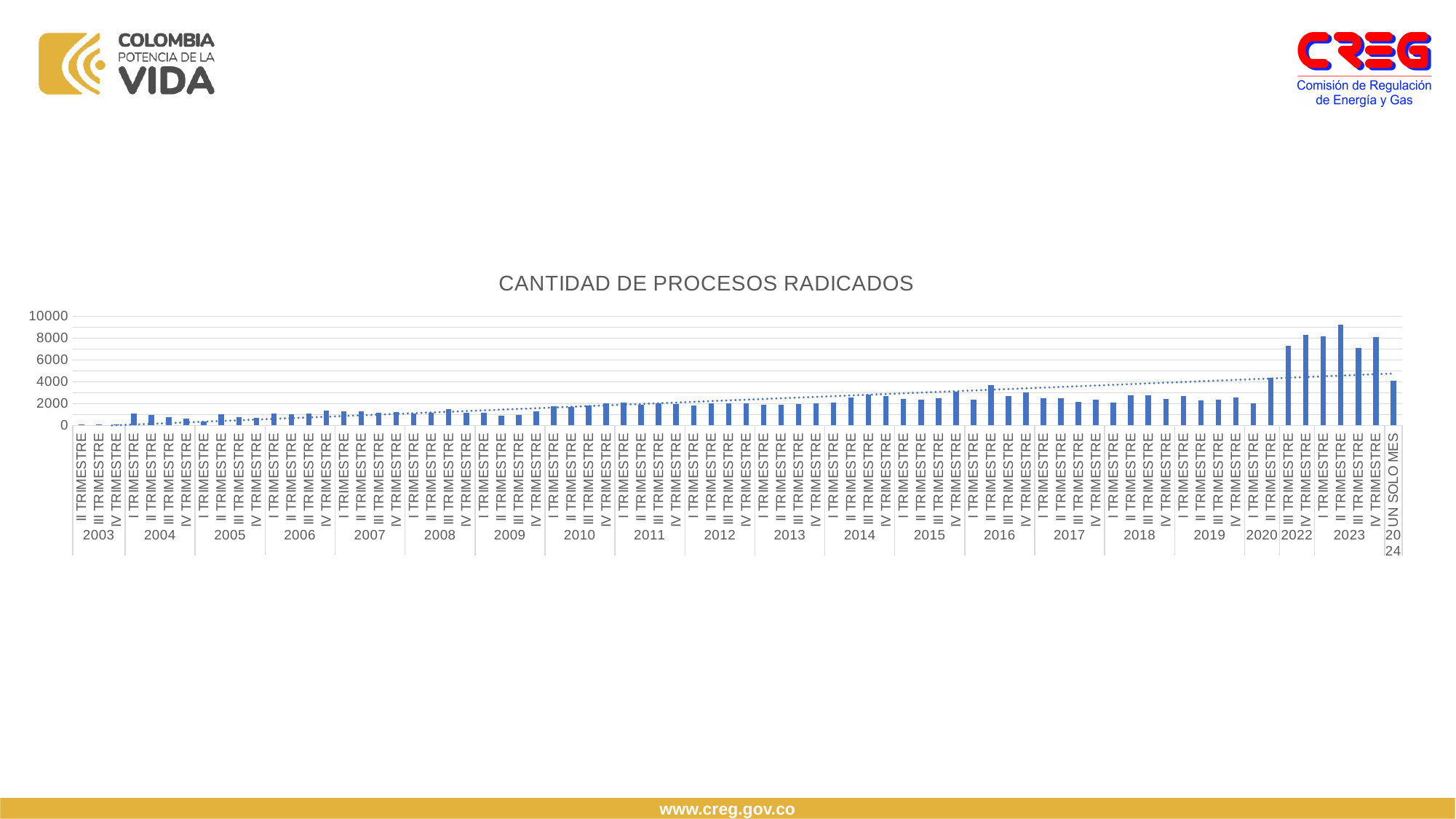
Is the value for II TRIMESTRE 2023 greater or less than 8000? greater What is the highest value shown on the y axis? 10000 Overall, do the values rise or fall from 2003 to 2024 along the x axis? rise What kind of chart is shown on the slide? bar chart Is the value for UN SOLO MES 2024 greater or less than 6000? less Is the value for I TRIMESTRE 2004 greater or less than 2000? less Which is larger, the value for II TRIMESTRE 2023 or the value for III TRIMESTRE 2022? II TRIMESTRE 2023 Which quarter has the highest number of procesos radicados? II TRIMESTRE 2023 What is the title of the chart? CANTIDAD DE PROCESOS RADICADOS